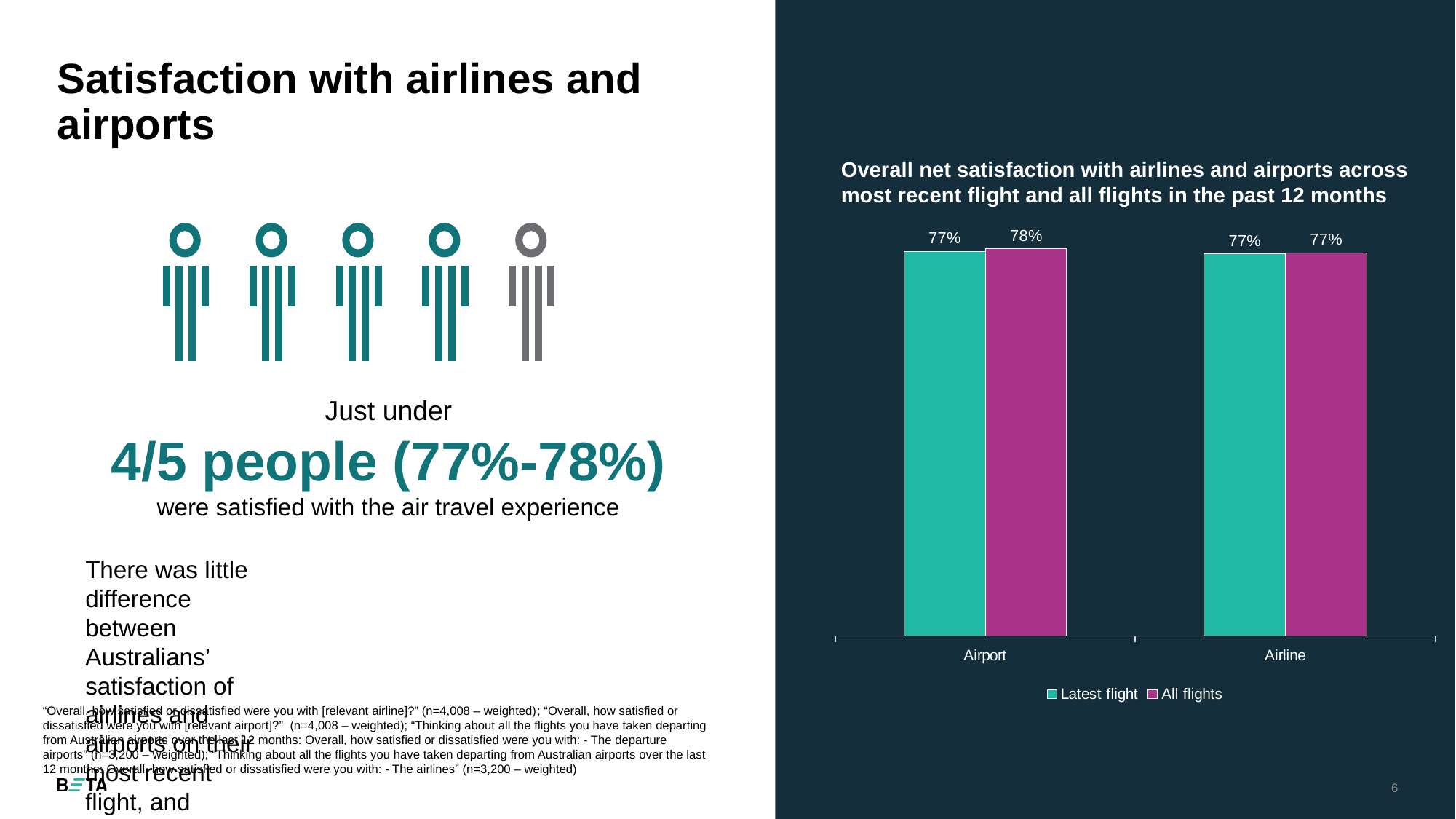
What is the value for Airline in the All flights series? 77% What is the value for Airport in the All flights series? 78% For Airport, what is the difference between the All flights value and the Latest flight value? 1 percentage point Which category and series combination has the highest value in the chart? Airport, All flights (78%) What is the title of the chart? Overall net satisfaction with airlines and airports across most recent flight and all flights in the past 12 months Which series is shown in magenta/purple in the chart? All flights For Airport, which is larger: the Latest flight value or the All flights value? All flights What is the value for Airport in the Latest flight series? 77% How many series does the chart legend list? 2 What is the value for Airline in the Latest flight series? 77% What kind of chart is shown on the slide? Bar chart How many categories are shown on the x axis of the chart? 2